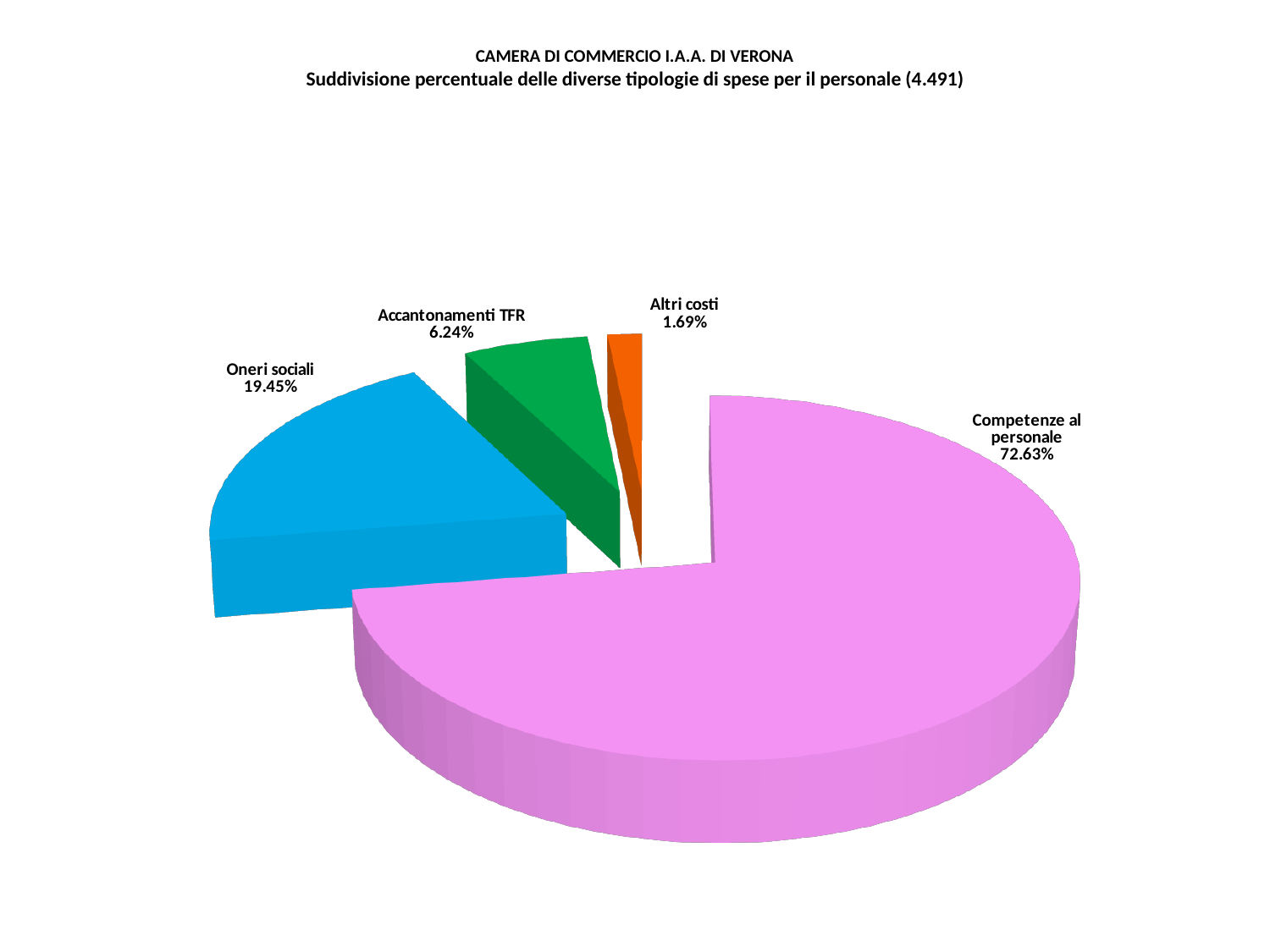
What percentage share does Altri costi have? 1.69% What percentage share does Competenze al personale have? 72.63% What is the difference in percentage points between Oneri sociali and Accantonamenti TFR? 13.21 What kind of chart is shown on the slide? pie chart How many slices does the pie chart have? 4 What colour is the slice for Oneri sociali? blue What is the difference in percentage points between Competenze al personale and Oneri sociali? 53.18 What percentage share does Accantonamenti TFR have? 6.24% Which is larger, the share for Accantonamenti TFR or the share for Altri costi? Accantonamenti TFR Which category has the largest share of the pie? Competenze al personale What percentage share does Oneri sociali have? 19.45% Which category has the smallest share of the pie? Altri costi